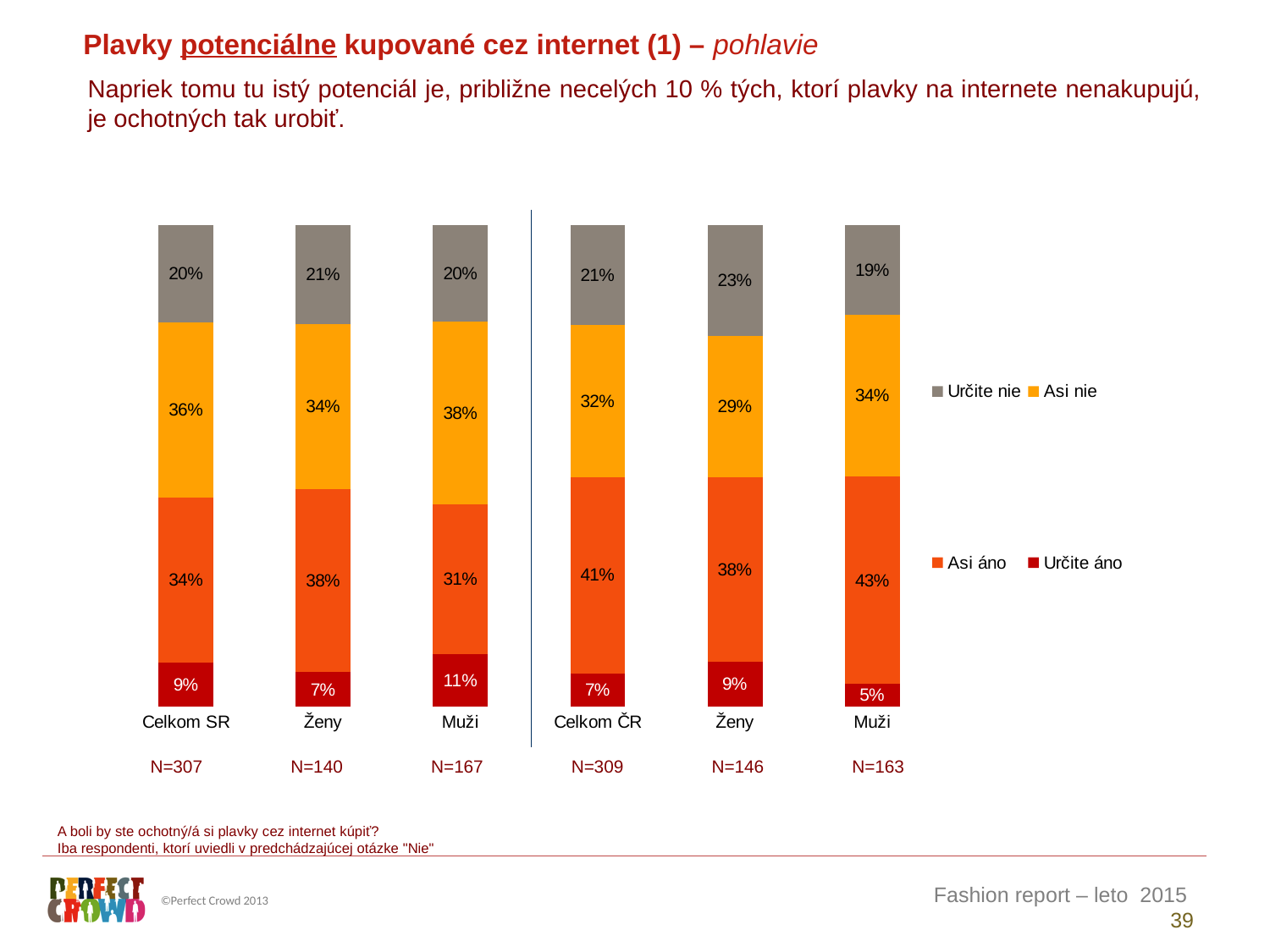
What kind of chart is shown on the slide? Stacked bar chart Which bar has the lowest "Určite áno" value? Muži (ČR, N=163) Which has the larger "Asi áno" value in the SR group: Ženy or Muži? Ženy What is the difference between the "Asi nie" values for Celkom SR and Celkom ČR? 4 percentage points What is the combined share of "Asi áno" and "Určite áno" for Celkom ČR? 48% What is the value of the "Určite nie" segment for Ženy in the ČR group (N=146)? 23% Which bar has the highest "Určite áno" value? Muži (SR, N=167) What is the value of the "Určite áno" segment for Muži in the SR group (N=167)? 11% How many series does the legend list? 4 What is the value of the "Asi nie" segment for Celkom SR? 36% What is the value of the "Asi áno" segment for Celkom ČR? 41% How many bars are shown in the chart? 6